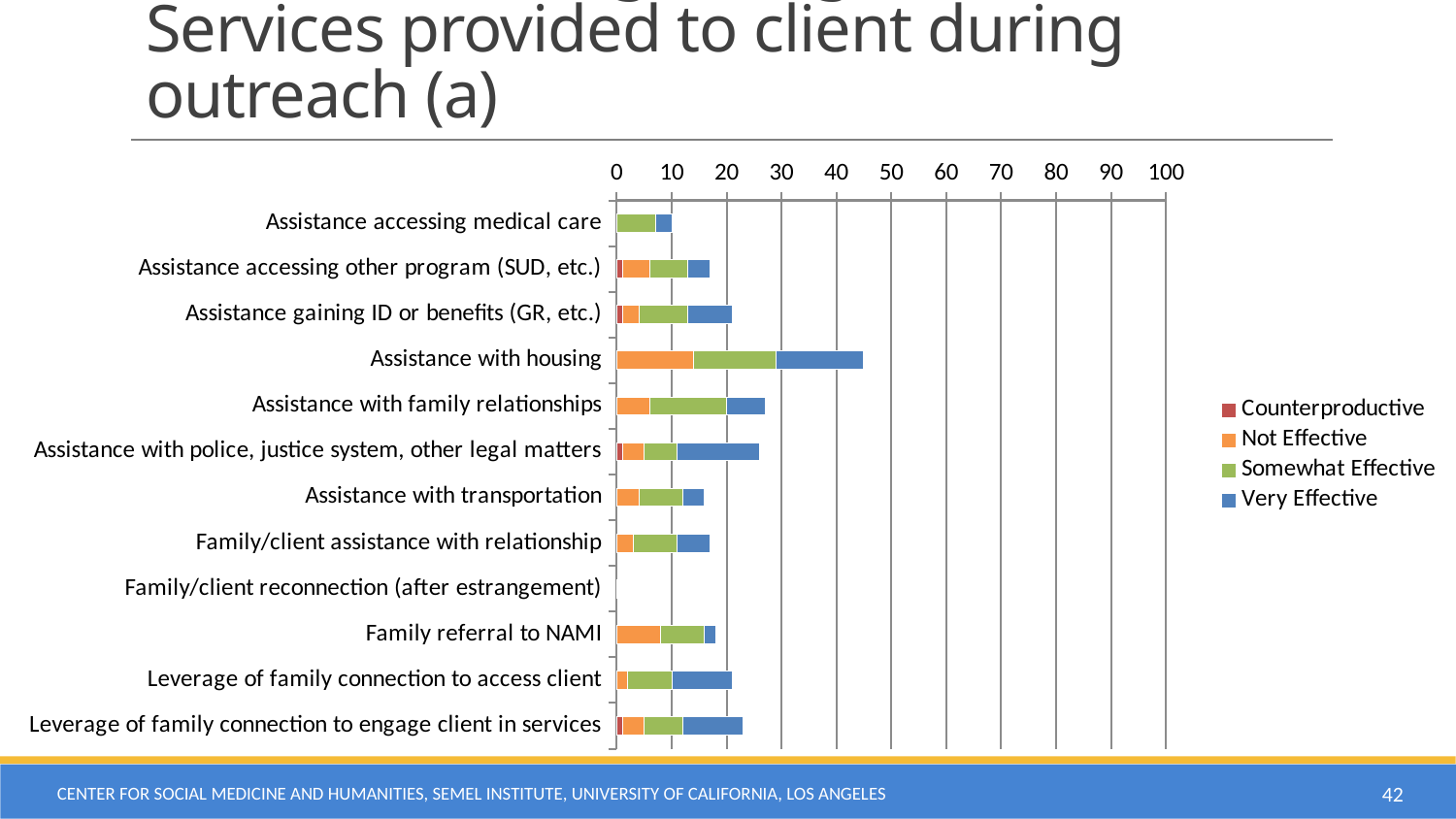
Which has the longer total bar: Assistance with family relationships or Assistance with transportation? Assistance with family relationships How many series does the legend list? 4 How many service categories are listed on the chart? 12 Which service category shows no bar at all? Family/client reconnection (after estrangement) What is the highest value shown on the horizontal axis? 100 Is the total bar for Assistance with transportation greater or less than 20? less What kind of chart is shown on the slide? Stacked bar chart Which legend entry is shown in blue? Very Effective Is the total bar for Assistance with housing greater or less than 40? greater Which service category has the longest total bar? Assistance with housing Is the total bar for Assistance accessing medical care greater or less than 20? less